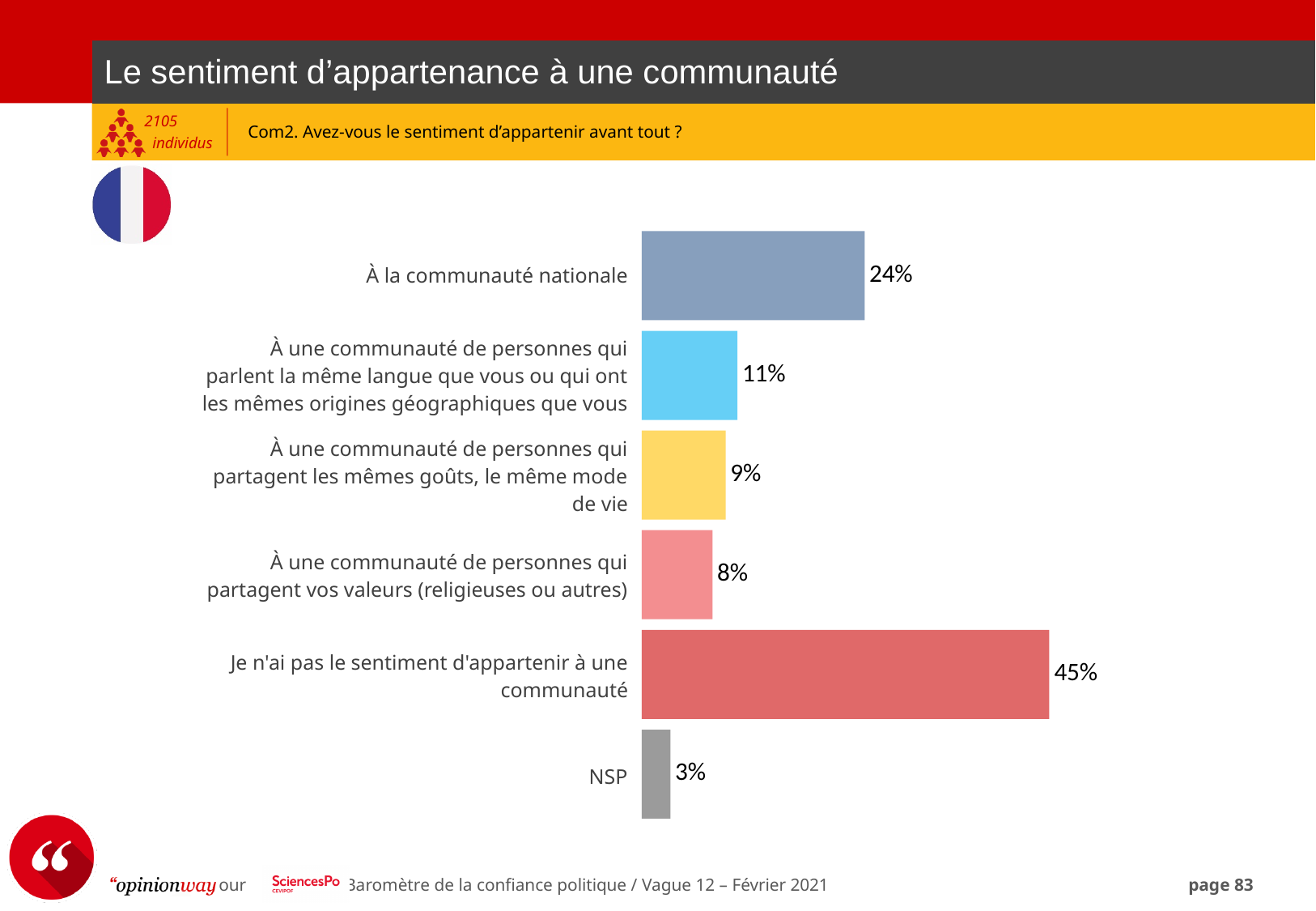
How many categories are shown in the chart? 6 What is the value for "Je n'ai pas le sentiment d'appartenir à une communauté"? 45% What is the value for "À la communauté nationale"? 24% What is the difference between the value for "Je n'ai pas le sentiment d'appartenir à une communauté" and the value for "À la communauté nationale"? 21% Which category has the lowest value? NSP Which is larger: the value for "À une communauté de personnes qui parlent la même langue que vous ou qui ont les mêmes origines géographiques que vous" or the value for "À une communauté de personnes qui partagent les mêmes goûts, le même mode de vie"? À une communauté de personnes qui parlent la même langue que vous ou qui ont les mêmes origines géographiques que vous Which category has the highest value? Je n'ai pas le sentiment d'appartenir à une communauté What is the value for "NSP"? 3% What kind of chart is shown on the slide? Bar chart What survey question is shown above the chart? Com2. Avez-vous le sentiment d'appartenir avant tout ? What is the difference between the value for "À une communauté de personnes qui parlent la même langue que vous ou qui ont les mêmes origines géographiques que vous" and the value for "NSP"? 8% What is the value for "À une communauté de personnes qui partagent vos valeurs (religieuses ou autres)"? 8%